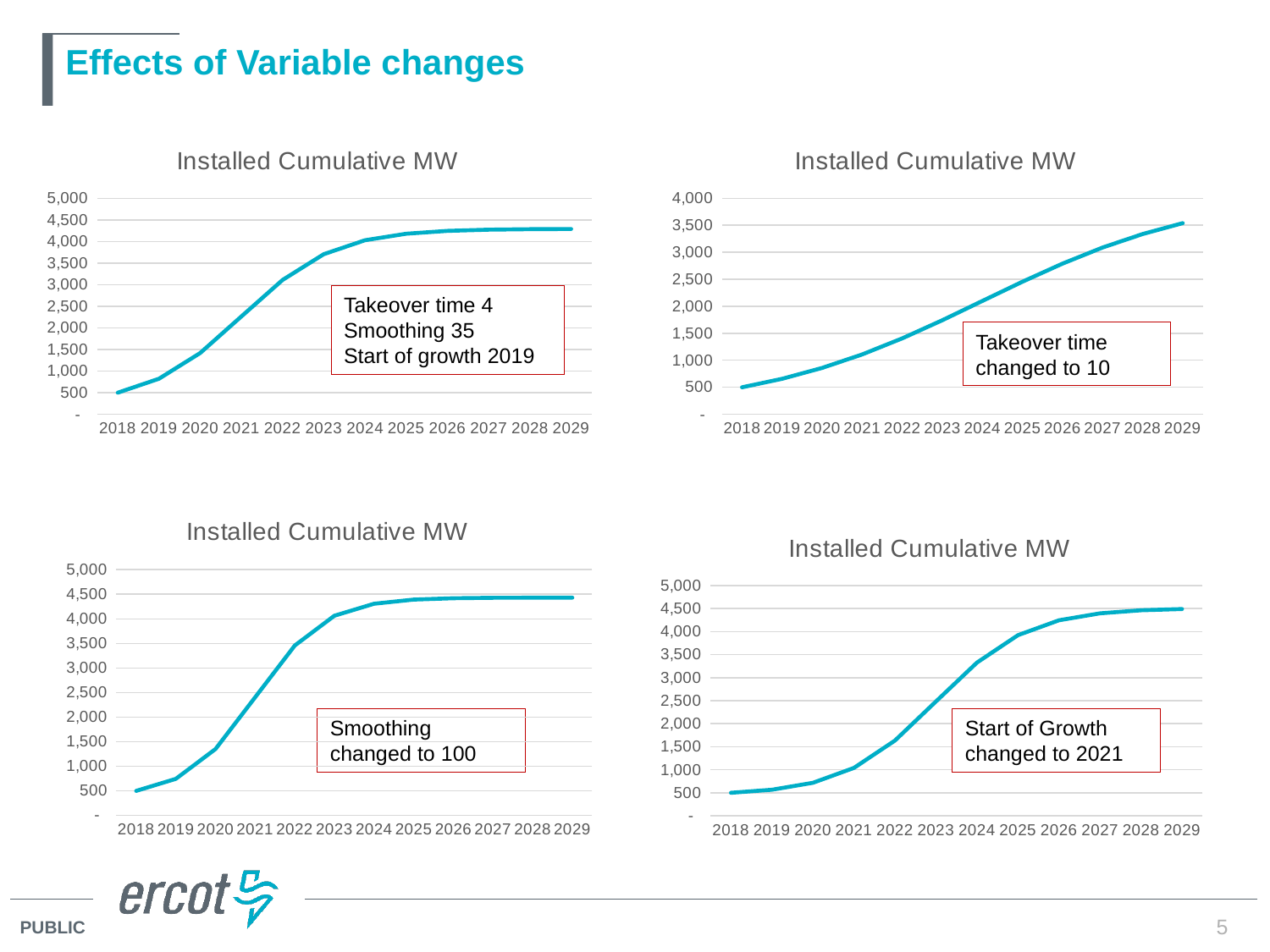
In the top-right chart, is the value for 2023 greater or less than 2,000? less In the top-left chart, do the values rise or fall from 2018 to 2029? rise In the top-right chart, is the value for 2029 greater or less than 3,000? greater In the bottom-left chart, is the value for 2022 greater or less than 3,000? greater In the top-left chart, what is the value for 2018? 500 In the bottom-right chart, which year has the lowest value? 2018 What does the text box in the top-right chart say the takeover time was changed to? 10 In the top-right chart, which is larger, the value for 2025 or the value for 2020? 2025 How many years are shown on the x axis of the top-right chart? 12 What type of chart is the top-left chart on the slide? line chart